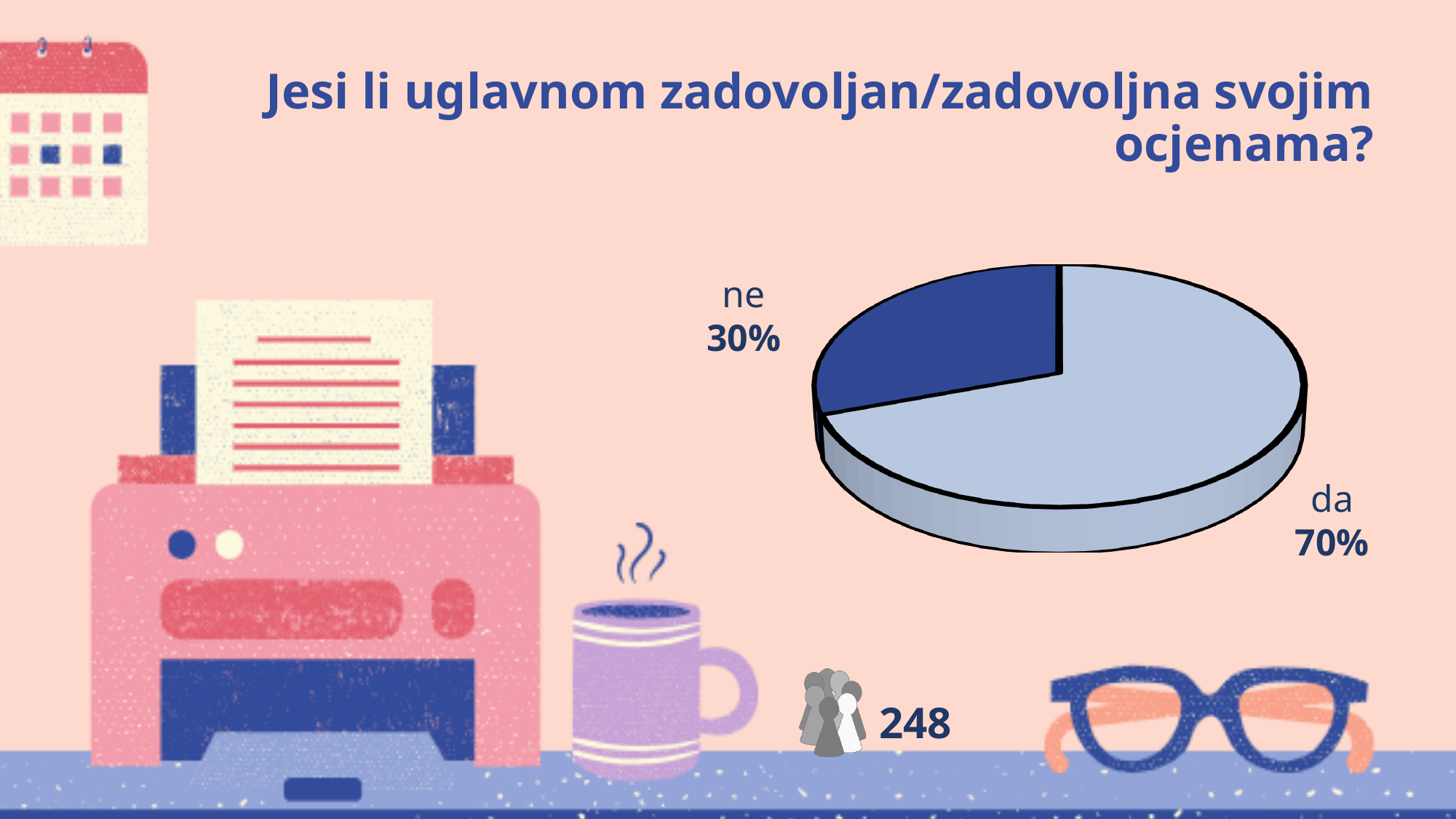
How many slices does the pie chart have? 2 What is the title of the chart on the slide? Jesi li uglavnom zadovoljan/zadovoljna svojim ocjenama? What share of the pie does the "ne" slice represent? 30% What share of the pie does the "da" slice represent? 70% What colour is the "ne" slice of the pie? dark blue What number is shown next to the people icon at the bottom of the slide? 248 Which slice of the pie is the largest? da Which is larger, the "da" slice or the "ne" slice? da Which slice of the pie is the smallest? ne What is the difference in percentage points between the "da" and "ne" slices? 40% What kind of chart is shown on the slide? pie chart